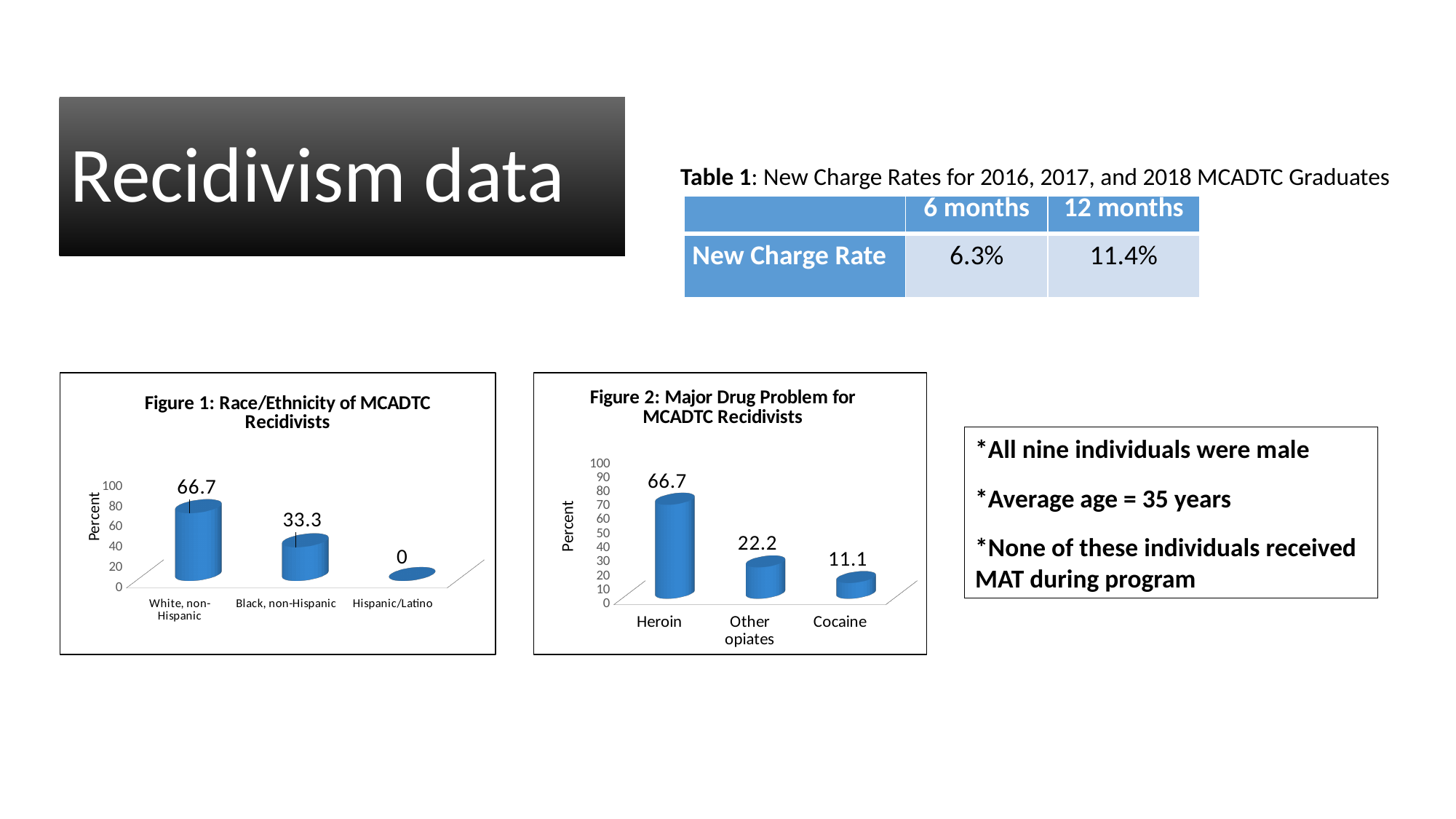
What kind of chart is Figure 2: Major Drug Problem for MCADTC Recidivists? Bar chart In Figure 2: Major Drug Problem for MCADTC Recidivists, which is larger, the value for Other opiates or the value for Cocaine? Other opiates In Figure 1: Race/Ethnicity of MCADTC Recidivists, what is the value for Black, non-Hispanic? 33.3 In Figure 1: Race/Ethnicity of MCADTC Recidivists, which category has the lowest value? Hispanic/Latino In Figure 2: Major Drug Problem for MCADTC Recidivists, what is the value for Other opiates? 22.2 In Figure 2: Major Drug Problem for MCADTC Recidivists, which category has the highest value? Heroin In Figure 1: Race/Ethnicity of MCADTC Recidivists, what is the value for White, non-Hispanic? 66.7 What is the y-axis label of Figure 1: Race/Ethnicity of MCADTC Recidivists? Percent In Figure 1: Race/Ethnicity of MCADTC Recidivists, what is the difference between the White, non-Hispanic and Black, non-Hispanic values? 33.4 In Figure 2: Major Drug Problem for MCADTC Recidivists, what is the value for Cocaine? 11.1 In Figure 1: Race/Ethnicity of MCADTC Recidivists, how many categories are shown on the x axis? 3 In Figure 2: Major Drug Problem for MCADTC Recidivists, what is the difference between the Heroin and Cocaine values? 55.6